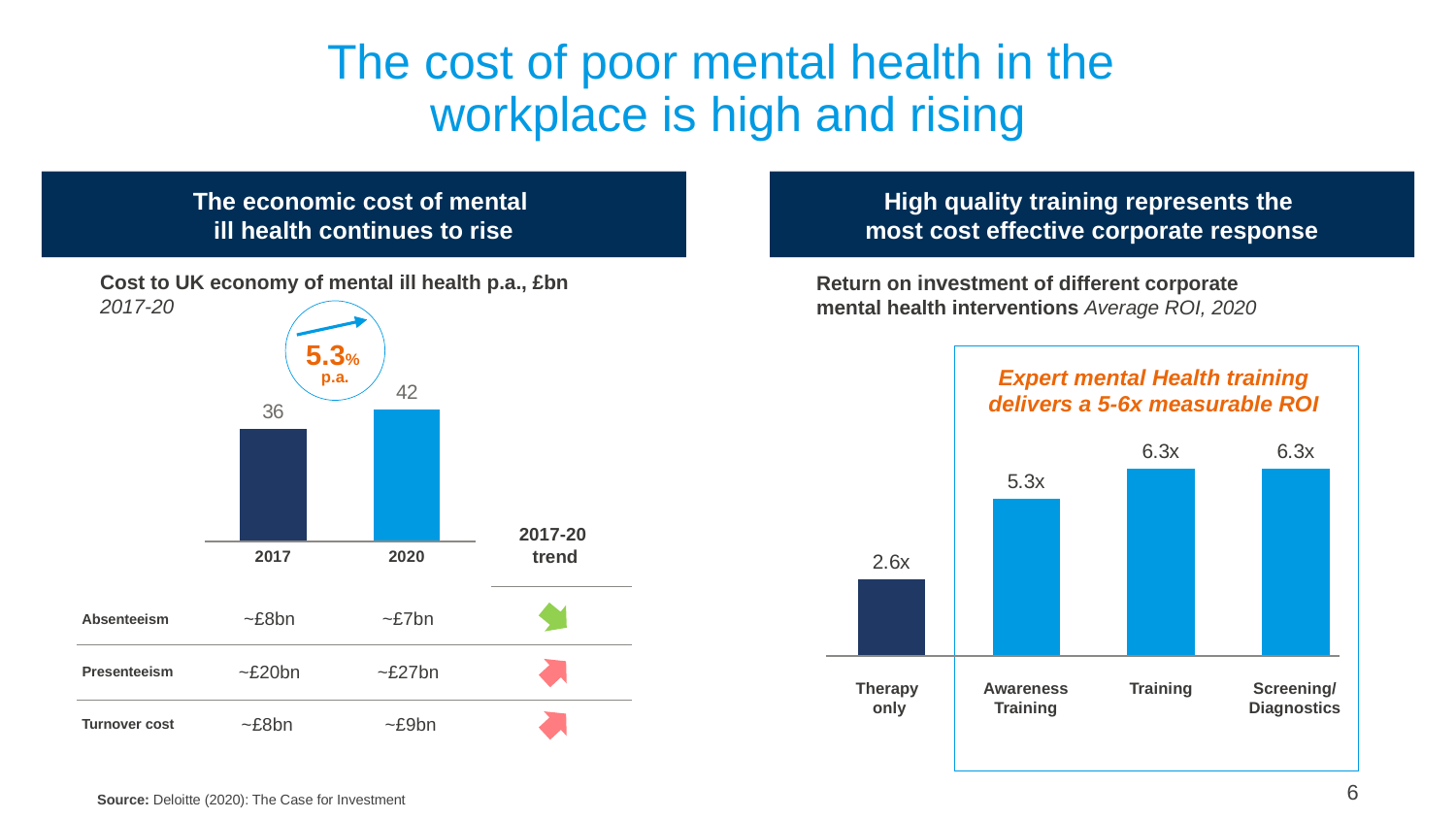
In the 'Return on investment of different corporate mental health interventions' chart, what is the average ROI for Screening/Diagnostics? 6.3x What type of chart is the 'Return on investment of different corporate mental health interventions' chart? bar chart How many interventions are shown in the 'Return on investment of different corporate mental health interventions' chart? 4 In the 'Cost to UK economy of mental ill health p.a., £bn' chart, what annual growth rate is shown in the circle above the bars? 5.3% p.a. In the 'Return on investment of different corporate mental health interventions' chart, which has the larger ROI, Therapy only or Awareness Training? Awareness Training In the 'Cost to UK economy of mental ill health p.a., £bn' chart, do the values rise or fall from 2017 to 2020? rise In the 'Return on investment of different corporate mental health interventions' chart, which intervention has the lowest average ROI? Therapy only In the 'Cost to UK economy of mental ill health p.a., £bn' chart, what is the difference between the 2020 and 2017 values? 6 In the 'Return on investment of different corporate mental health interventions' chart, what is the average ROI for Awareness Training? 5.3x In the 'Return on investment of different corporate mental health interventions' chart, what is the average ROI for Therapy only? 2.6x In the 'Cost to UK economy of mental ill health p.a., £bn' chart, what is the value for 2017? 36 In the 'Cost to UK economy of mental ill health p.a., £bn' chart, what is the value for 2020? 42